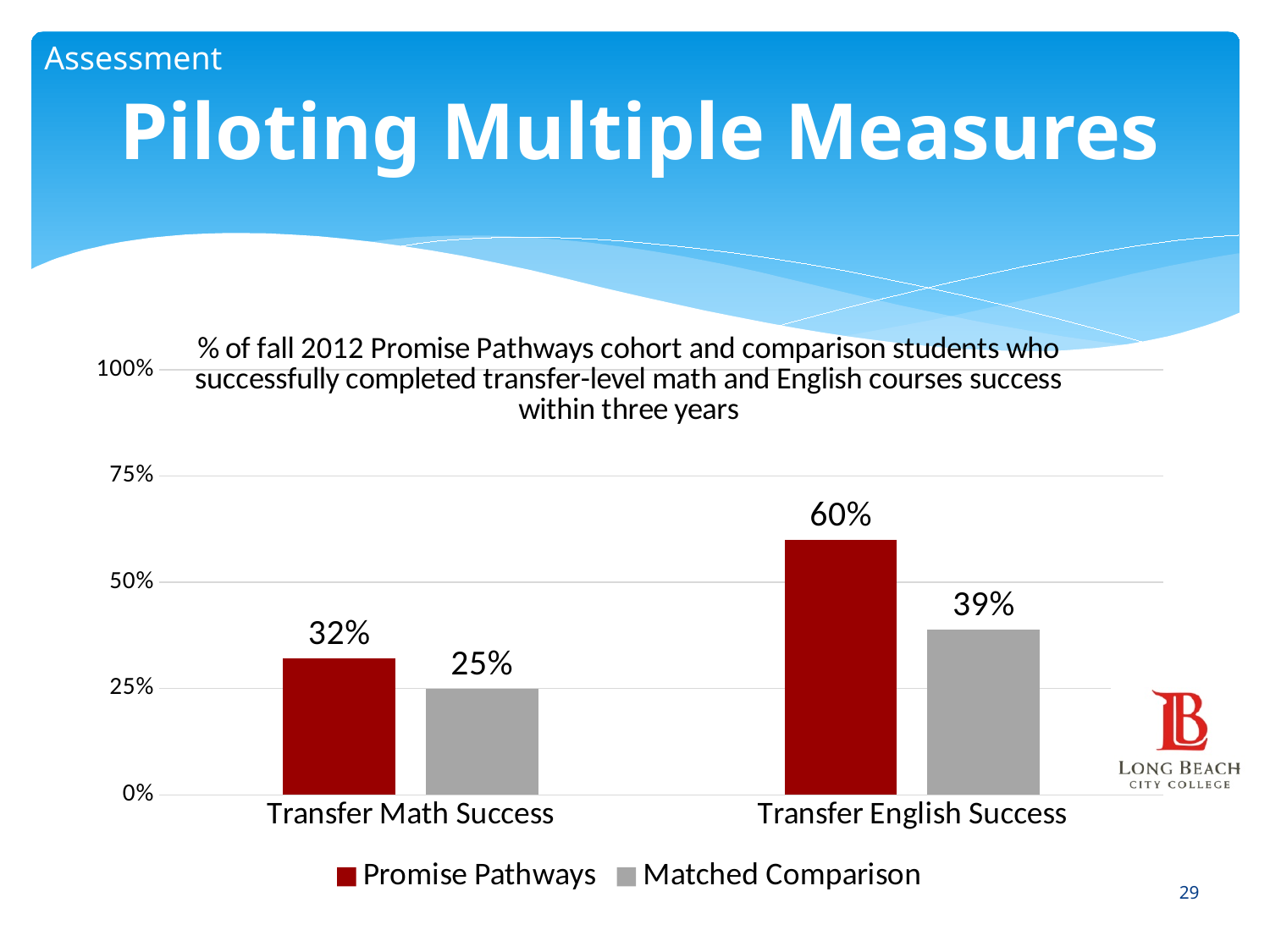
Which is larger for Transfer Math Success: Promise Pathways or Matched Comparison? Promise Pathways Which bar has the highest value on the chart? Promise Pathways, Transfer English Success What is the Matched Comparison value for Transfer Math Success? 25% How many series does the legend list? 2 What is the Matched Comparison value for Transfer English Success? 39% What kind of chart is shown on the slide? Bar chart What is the difference between the Promise Pathways and Matched Comparison values for Transfer Math Success? 7% Which bar has the lowest value on the chart? Matched Comparison, Transfer Math Success What is the Promise Pathways value for Transfer English Success? 60% How many categories are shown on the x axis? 2 What is the difference between the Promise Pathways and Matched Comparison values for Transfer English Success? 21% What is the Promise Pathways value for Transfer Math Success? 32%